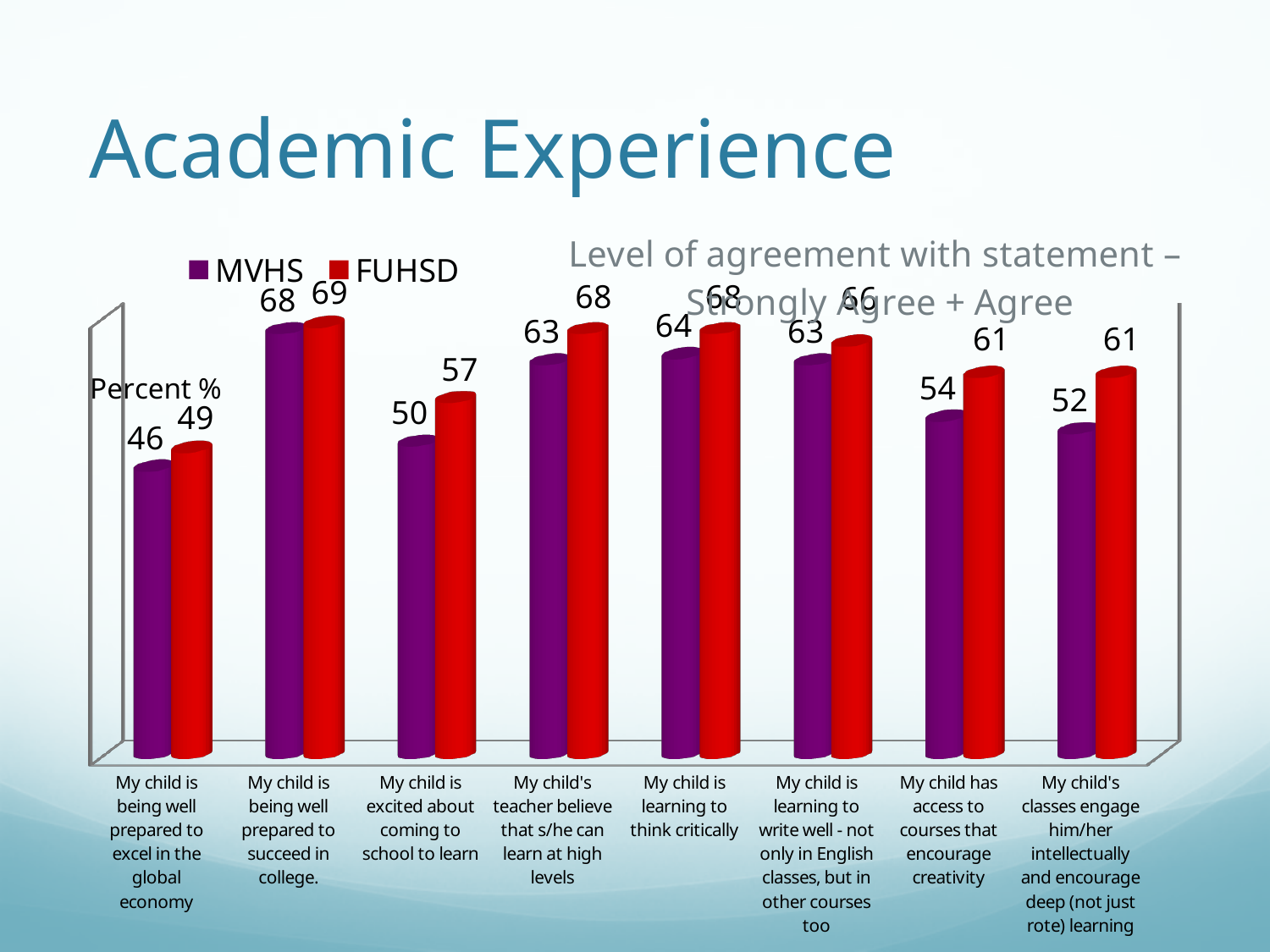
What is the FUHSD value for "My child is excited about coming to school to learn"? 57 For "My child's teacher believe that s/he can learn at high levels", which series has the larger value, MVHS or FUHSD? FUHSD What is the FUHSD value for "My child's classes engage him/her intellectually and encourage deep (not just rote) learning"? 61 What is the MVHS value for "My child is being well prepared to excel in the global economy"? 46 Which statement has the highest MVHS value? My child is being well prepared to succeed in college. What is the MVHS value for "My child has access to courses that encourage creativity"? 54 Which statement has the lowest FUHSD value? My child is being well prepared to excel in the global economy How many series does the legend list? 2 How many statements (categories) are shown on the x axis? 8 What kind of chart is shown on the slide? Bar chart Which colour represents the FUHSD series in the chart? Red What is the difference between the FUHSD and MVHS values for "My child is excited about coming to school to learn"? 7